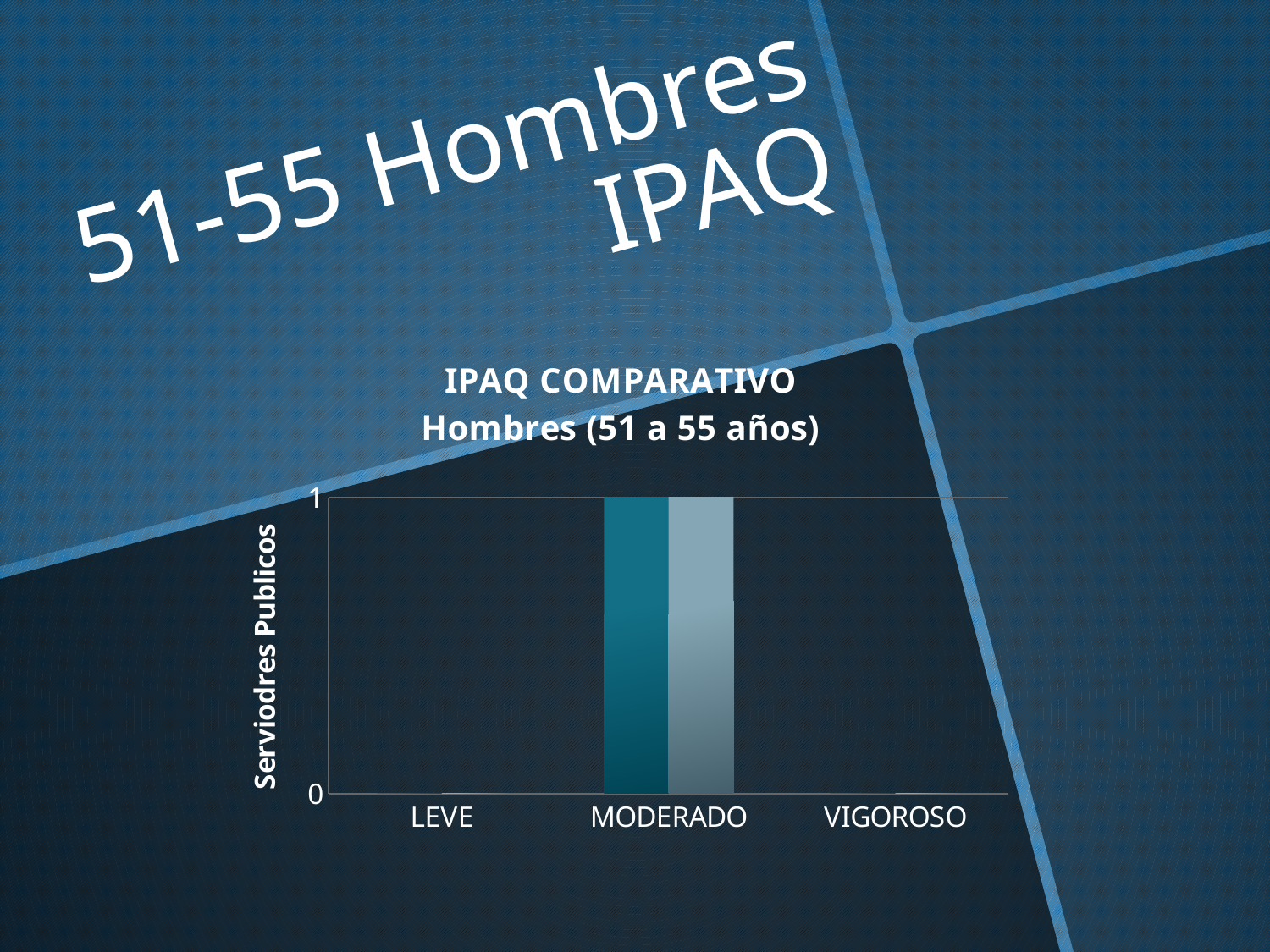
What is the title of the chart? IPAQ COMPARATIVO Hombres (51 a 55 años) What is the label of the vertical axis? Serviodres Publicos Which category has the highest value? MODERADO What kind of chart is shown on the slide? bar chart Which category has a larger value, MODERADO or LEVE? MODERADO How many categories are shown on the x axis? 3 Which category has a larger value, MODERADO or VIGOROSO? MODERADO What value do the bars for MODERADO reach? 1 What is the highest tick value shown on the vertical axis? 1